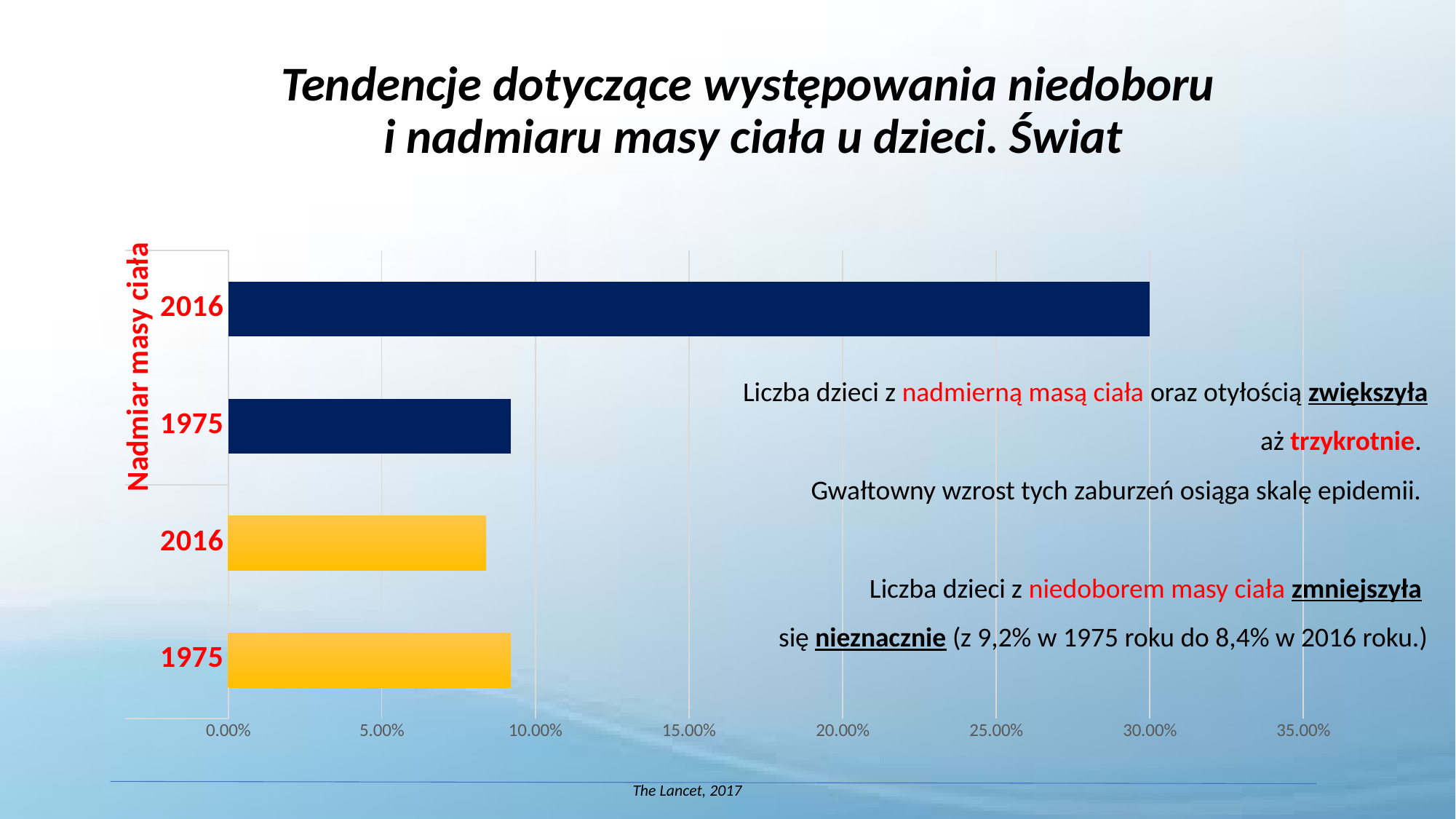
Which bar is the shortest in the chart? 2016 (yellow bar) Which bar is the longest in the chart? 2016 (Nadmiar masy ciała, top navy bar) How many bars are plotted in the chart? 4 What kind of chart is shown on the slide? bar chart Among the yellow bars, which year has the larger value, 1975 or 2016? 1975 What is the highest tick label shown on the x axis? 35.00% Is the value of the navy 1975 bar (Nadmiar masy ciała) greater or less than 10.00%? less Among the navy bars (Nadmiar masy ciała), which year has the larger value, 1975 or 2016? 2016 What is the red axis label written vertically next to the navy bars? Nadmiar masy ciała Is the value of the yellow 2016 bar greater or less than 10.00%? less What value does the top navy 2016 bar (Nadmiar masy ciała) reach on the x axis? 30.00% Is the value of the top navy 2016 bar greater or less than 25.00%? greater